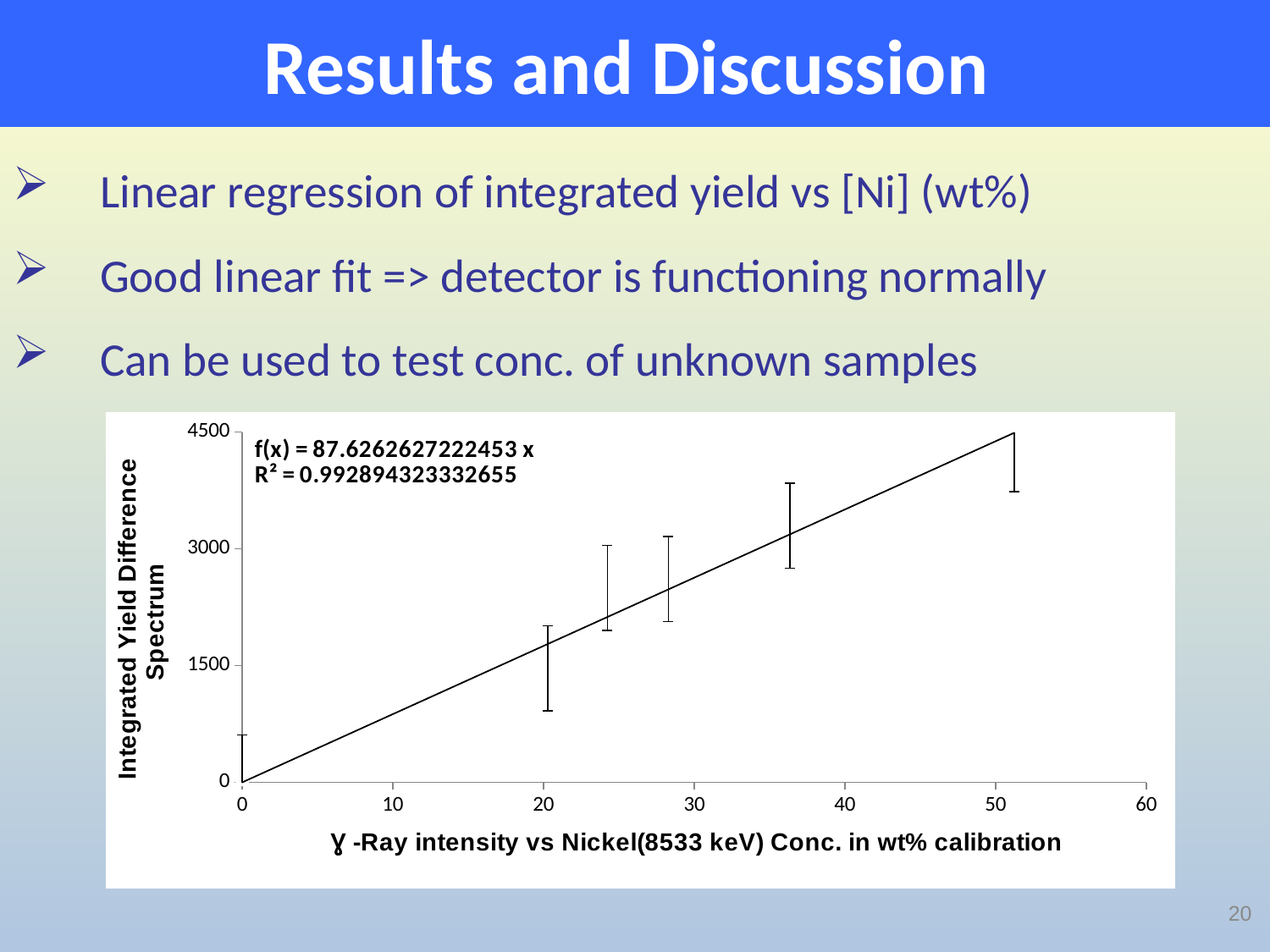
Does the integrated yield difference rise or fall as the x-axis value increases? rise Is the value of the data point near x = 20 greater or less than 3000? less What is the y-axis title of the chart? Integrated Yield Difference Spectrum What R² value is printed on the chart? 0.992894323332655 How many data points (error bars) are plotted on the chart? 6 What is the maximum value shown on the y-axis? 4500 Is the value of the data point near x = 36 greater or less than 1500? greater What kind of chart is shown on the slide? scatter chart with a linear trendline What is the fitted equation printed on the chart? f(x) = 87.6262627222453 x Is the value of the data point near x = 51 greater or less than 3000? greater What is the maximum value shown on the x-axis? 60 Which data point has the highest integrated yield difference, the one near x = 51 or the one near x = 20? the one near x = 51